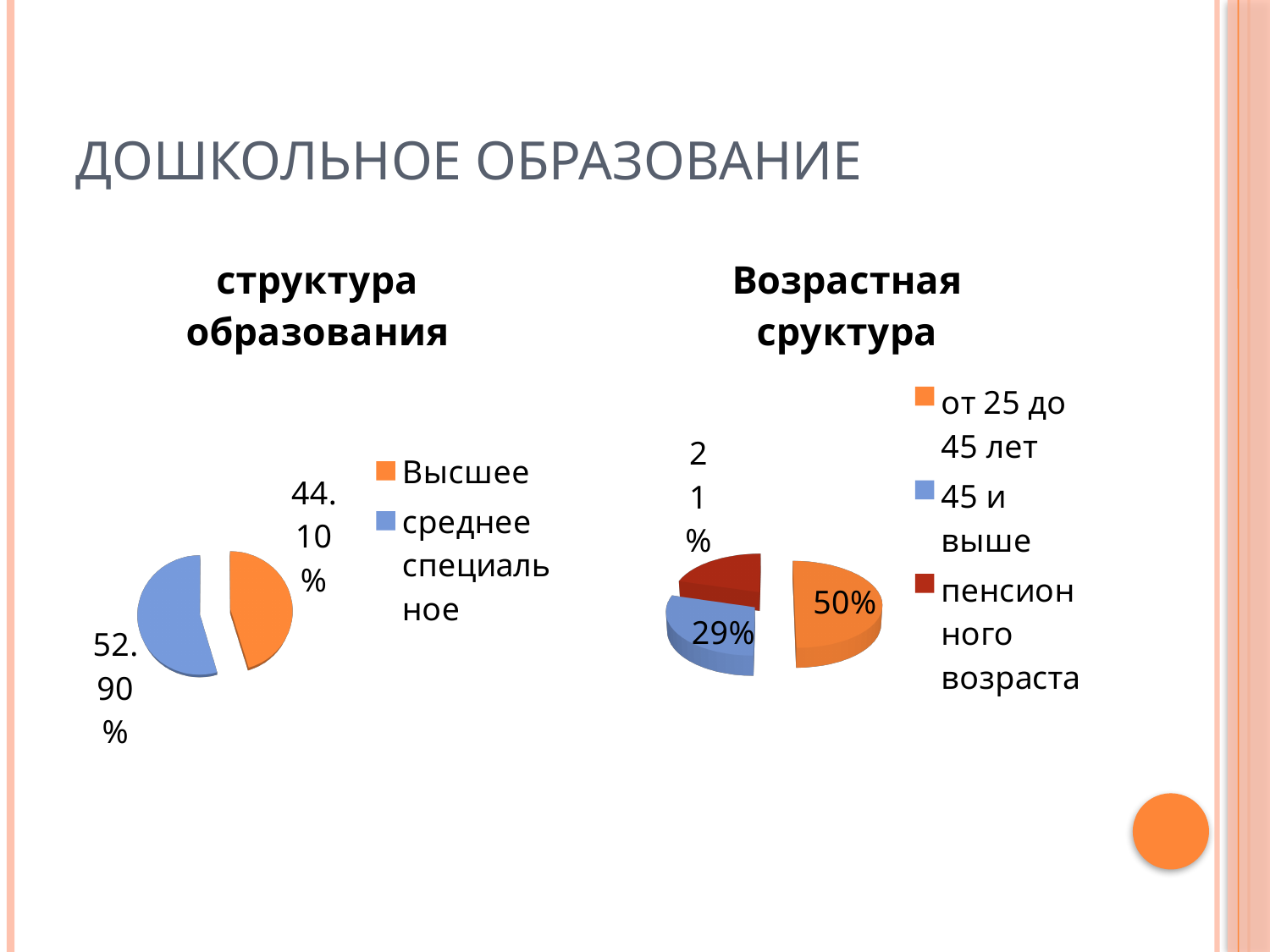
In the chart titled "структура образования", what is the value for среднее специальное? 52.90% In the chart titled "Возрастная сруктура", what is the value for от 25 до 45 лет? 50% In the chart titled "Возрастная сруктура", which category has the smallest share? пенсионного возраста In the chart titled "Возрастная сруктура", what is the value for 45 и выше? 29% In the chart titled "структура образования", what is the difference between среднее специальное and Высшее? 8.80% In the chart titled "структура образования", what is the value for Высшее? 44.10% In the chart titled "Возрастная сруктура", what is the value for пенсионного возраста? 21% What kind of chart is the chart titled "структура образования"? pie chart In the chart titled "Возрастная сруктура", which is larger: 45 и выше or пенсионного возраста? 45 и выше In the chart titled "Возрастная сруктура", what colour is the slice for от 25 до 45 лет? orange In the chart titled "структура образования", which category has the largest share? среднее специальное In the chart titled "Возрастная сруктура", how many categories does the legend list? 3